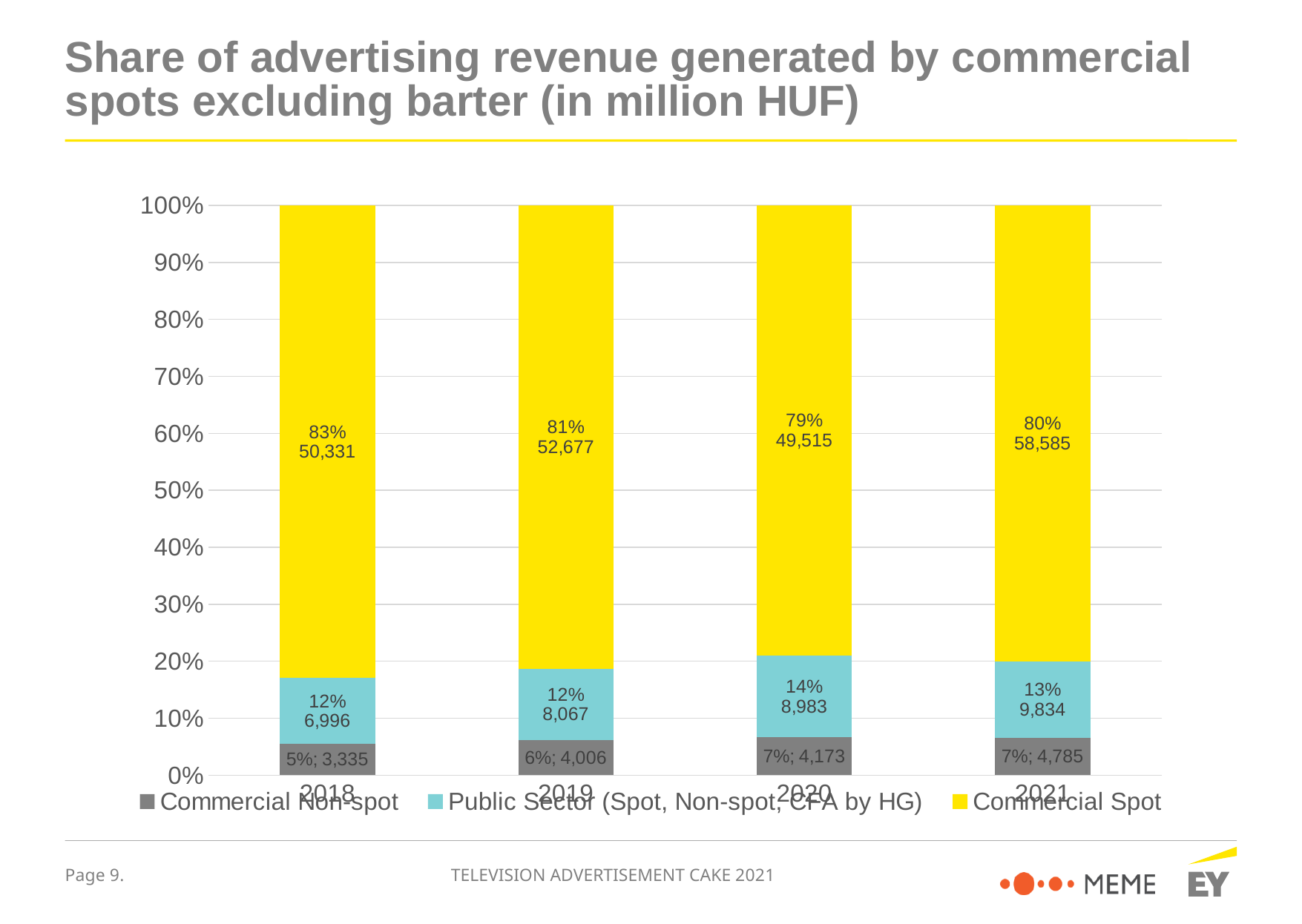
Which was larger in 2021: Public Sector revenue or Commercial Non-spot revenue? Public Sector revenue By how much did Commercial Spot revenue (in million HUF) increase from 2020 to 2021? 9,070 What share of advertising revenue did Commercial Spot generate in 2018? 83% What was the Commercial Spot revenue in 2021 (in million HUF)? 58,585 How many series does the legend list? 3 What share did Commercial Non-spot have in 2019? 6% In which year was the Commercial Spot share the highest? 2018 How many years are shown on the x axis? 4 In which year was the Commercial Spot share the lowest? 2020 What is the total revenue (in million HUF) across all three series in 2018? 60,662 What was the Public Sector (Spot, Non-spot, CFA by HG) revenue in 2020 (in million HUF)? 8,983 What kind of chart is shown on the slide? Stacked bar chart